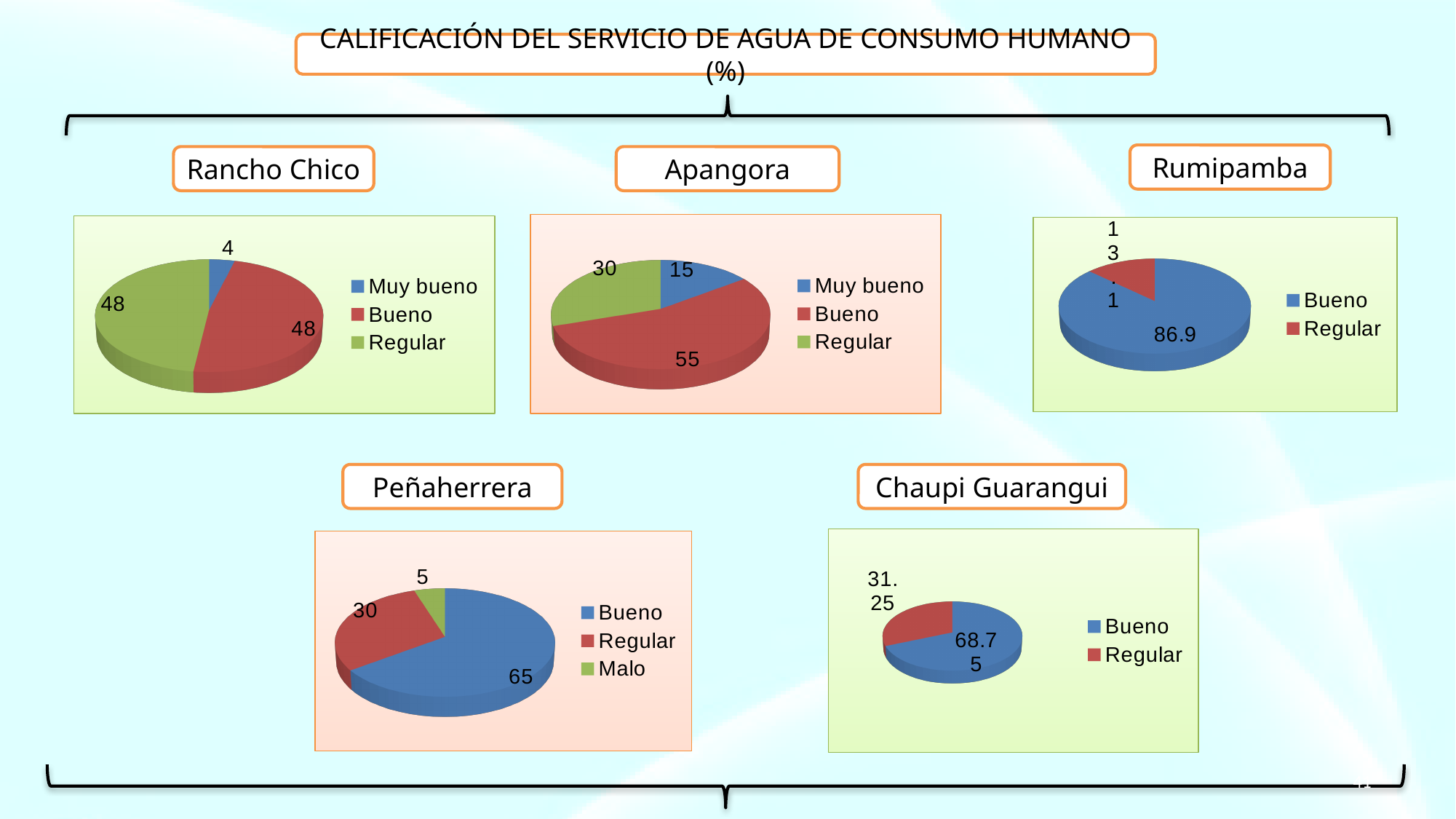
How many categories does the legend of the Rancho Chico pie chart list? 3 In the Chaupi Guarangui pie chart, which category has the larger slice? Bueno In the Peñaherrera pie chart, what is the value for Malo? 5 In the Peñaherrera pie chart, which is larger, Regular or Malo? Regular In the Apangora pie chart, what is the value for Bueno? 55 In the Peñaherrera pie chart, which category has the largest slice? Bueno In the Apangora pie chart, which category has the smallest slice? Muy bueno In the Apangora pie chart, what is the value for Regular? 30 In the Apangora pie chart, what is the difference between the Bueno and Regular values? 25 In the Rumipamba pie chart, what is the value for Bueno? 86.9 What type of chart is used for Rumipamba? Pie chart In the Rancho Chico pie chart, what is the value for Muy bueno? 4